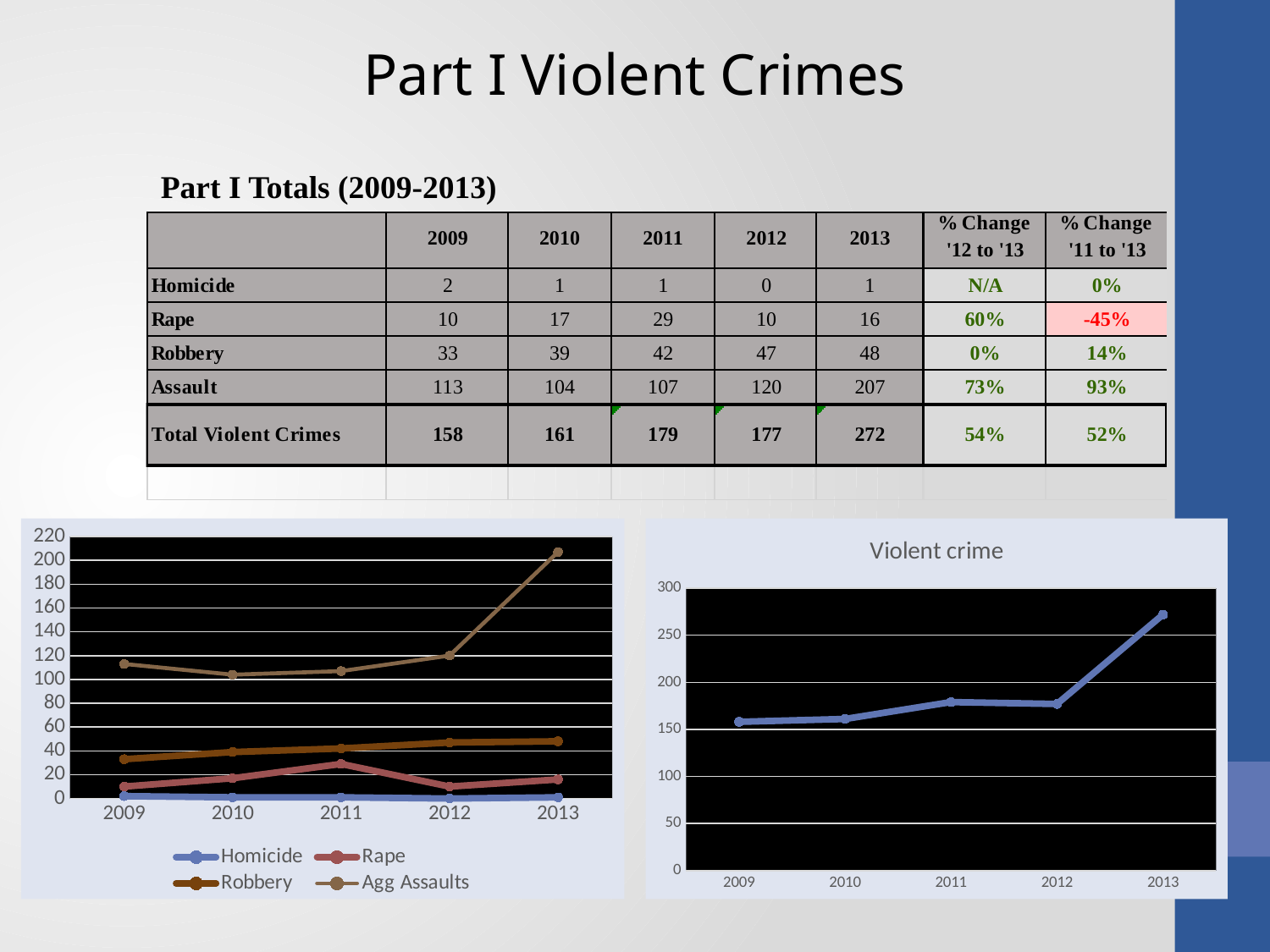
In the left chart, which is larger in 2012, Robbery or Rape? Robbery In the 'Violent crime' chart, is the value for 2013 greater or less than 250? greater What is the title of the right chart on the slide? Violent crime In the left chart, is the value for Agg Assaults in 2013 greater or less than 200? greater In the 'Violent crime' chart, do the values generally rise or fall from 2009 to 2013? rise How many years are plotted along the x axis of the 'Violent crime' chart? 5 How many series does the legend of the left chart list? 4 In the left chart, which series has the lowest values across all years? Homicide In the 'Violent crime' chart, is the value for 2009 greater or less than 200? less What kind of chart is the left chart on the slide? line chart In the left chart, which series has the highest value in 2013? Agg Assaults